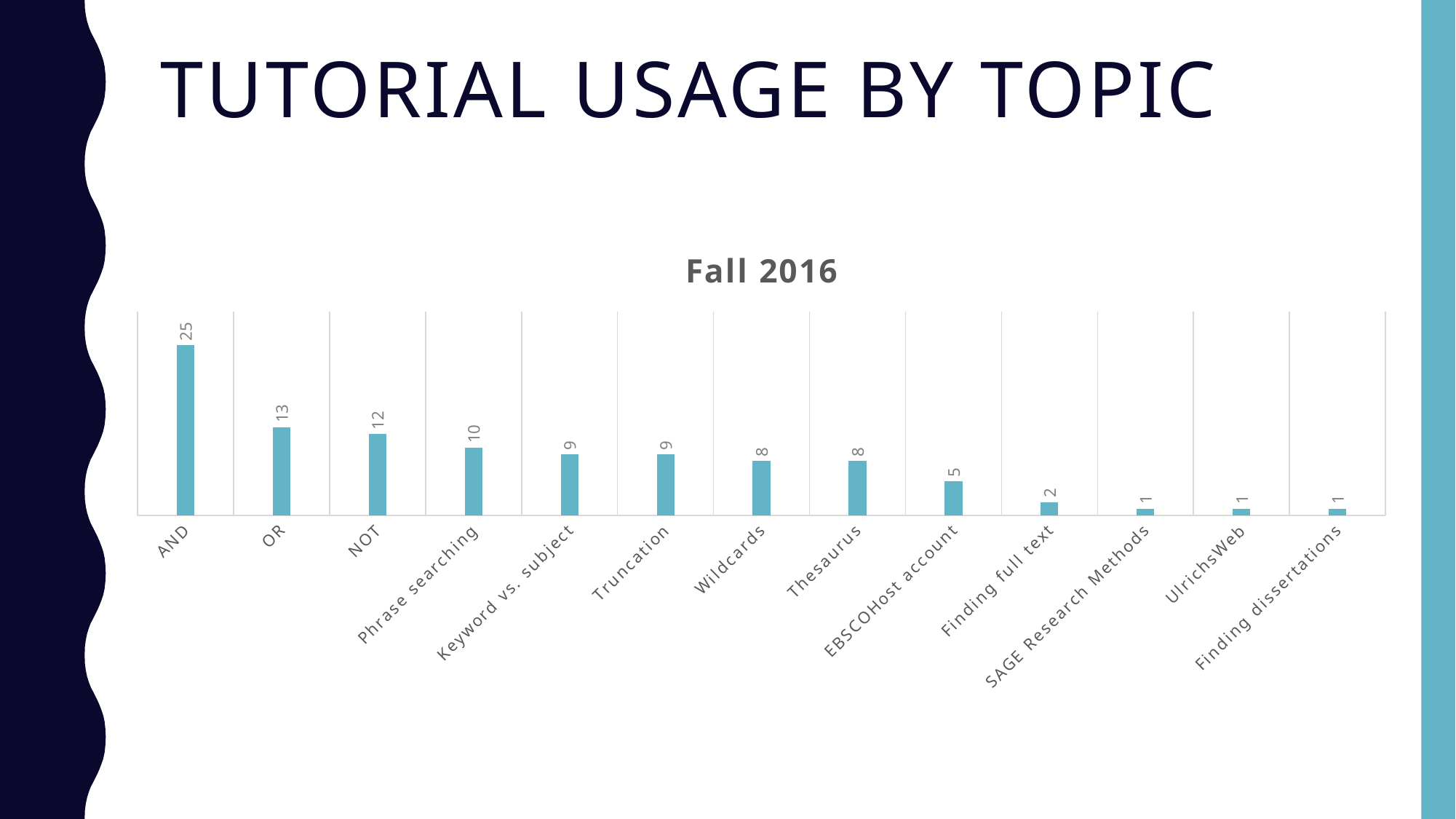
How many topics are shown on the x axis? 13 Which topic has the highest value? AND Which is larger, the value for OR or the value for Wildcards? OR What is the value for EBSCOHost account? 5 Do the values rise or fall from left to right along the x axis? fall What is the difference between the values for AND and OR? 12 What is the title of the chart? Fall 2016 What is the value for AND? 25 What is the difference between the values for NOT and Thesaurus? 4 What is the value for Finding full text? 2 What is the value for Phrase searching? 10 What kind of chart is this? bar chart